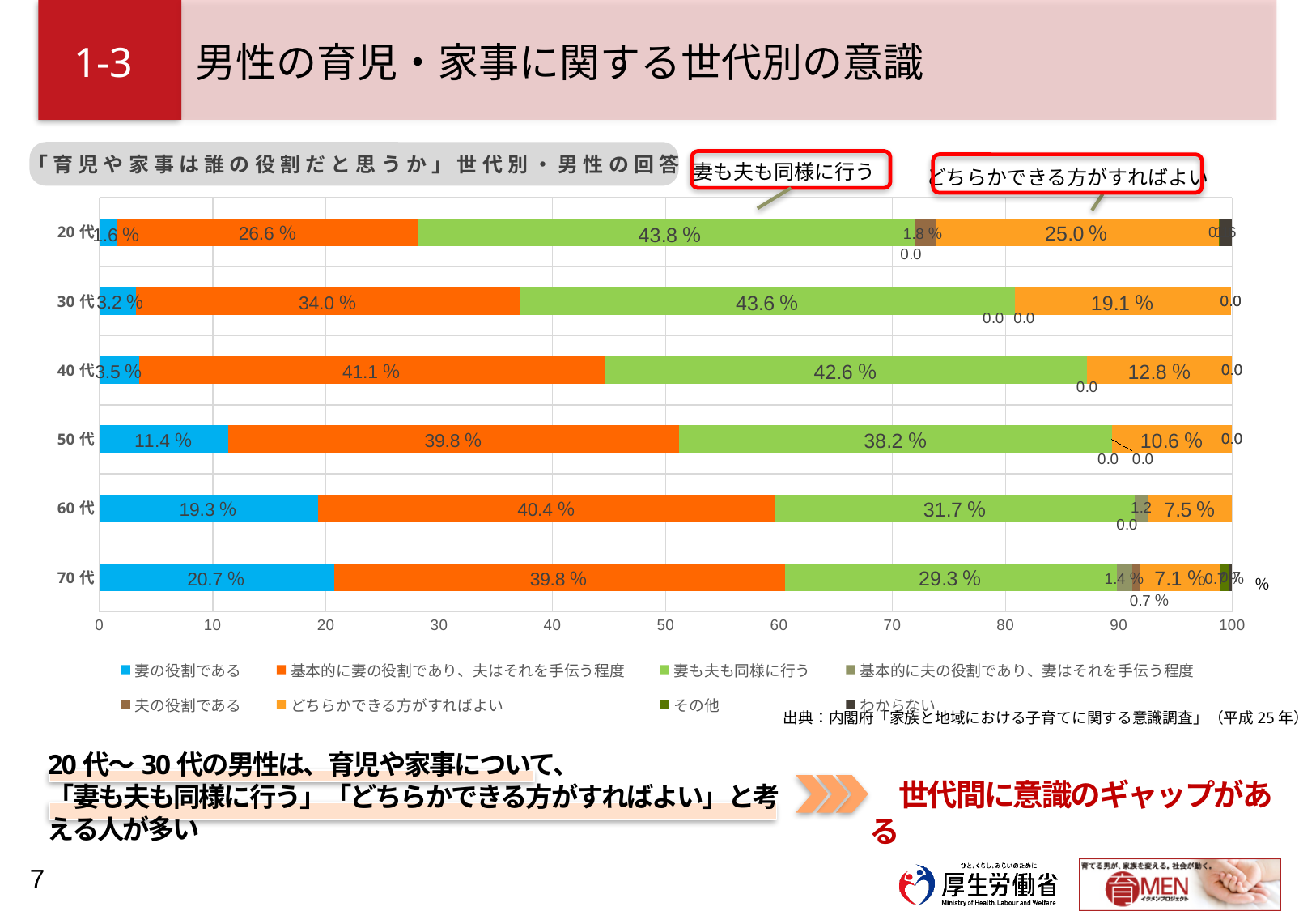
What is the difference between the 20代 and 70代 values for 妻も夫も同様に行う? 14.5 % What is the value for 妻の役割である in the 70代 bar? 20.7 % Which is larger for どちらかできる方がすればよい: 30代 or 40代? 30代 Which age group has the highest value for どちらかできる方がすればよい? 20代 What is the value for 基本的に妻の役割であり、夫はそれを手伝う程度 in the 40代 bar? 41.1 % What is the value for 妻も夫も同様に行う in the 20代 bar? 43.8 % Which age group has the lowest value for 妻の役割である? 20代 How many age groups are shown in the chart? 6 Which age group has the highest value for 妻の役割である? 70代 What is the value for どちらかできる方がすればよい in the 50代 bar? 10.6 % How many series does the legend list? 8 What kind of chart is shown on the slide? Stacked bar chart